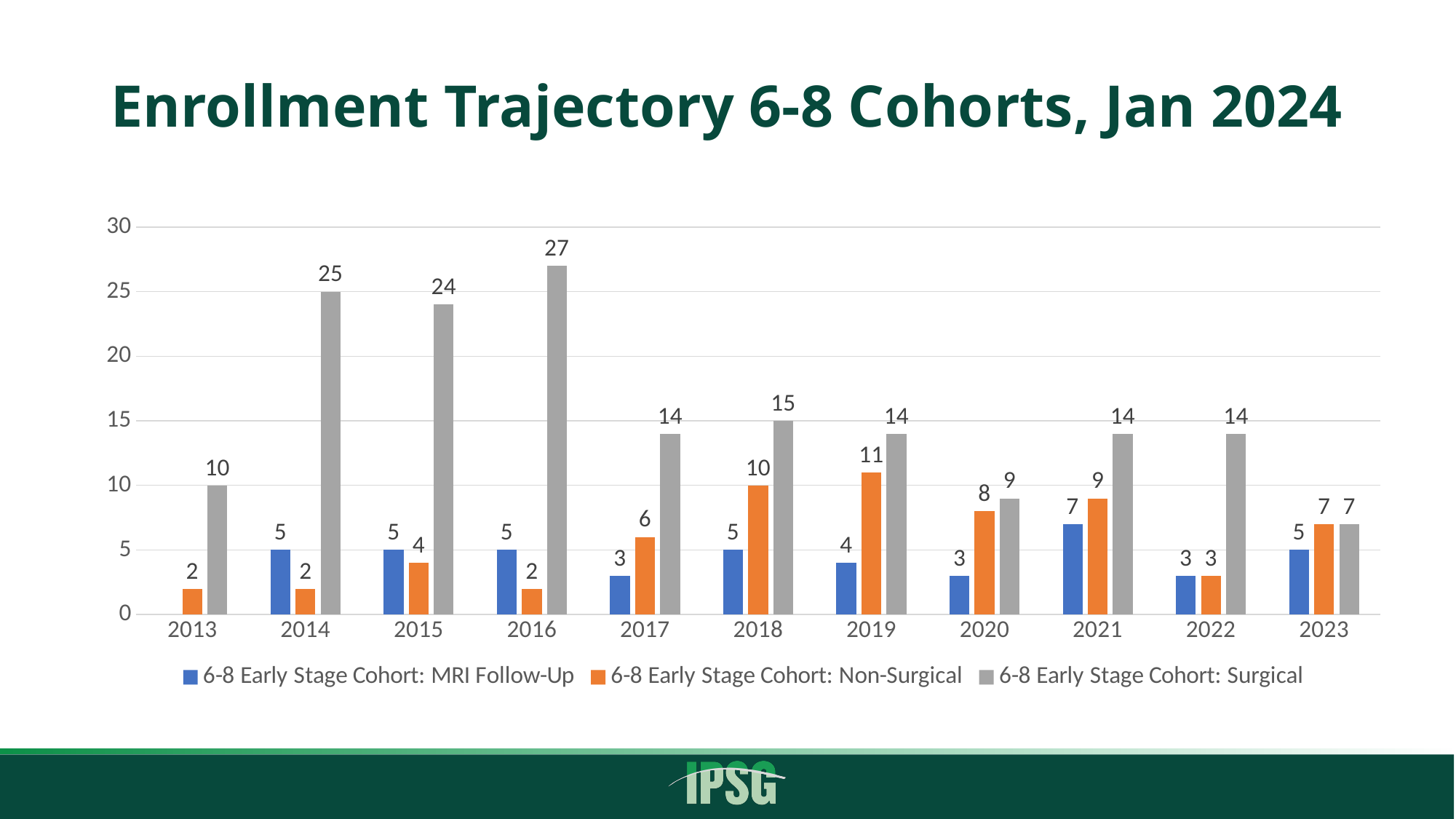
What colour represents the 6-8 Early Stage Cohort: Non-Surgical series? Orange In which year is the 6-8 Early Stage Cohort: Non-Surgical value highest? 2019 What is the value for the 6-8 Early Stage Cohort: Surgical series in 2016? 27 What is the difference between the Surgical and Non-Surgical values in 2018? 5 What is the value for the 6-8 Early Stage Cohort: Non-Surgical series in 2019? 11 How many series does the legend list? 3 What is the value for the 6-8 Early Stage Cohort: MRI Follow-Up series in 2021? 7 In which year is the 6-8 Early Stage Cohort: Surgical value highest? 2016 What is the difference between the Surgical values in 2014 and 2015? 1 What kind of chart is shown on the slide? Bar chart How many years are shown on the x axis? 11 Which is larger in 2020: the Non-Surgical value or the Surgical value? Surgical